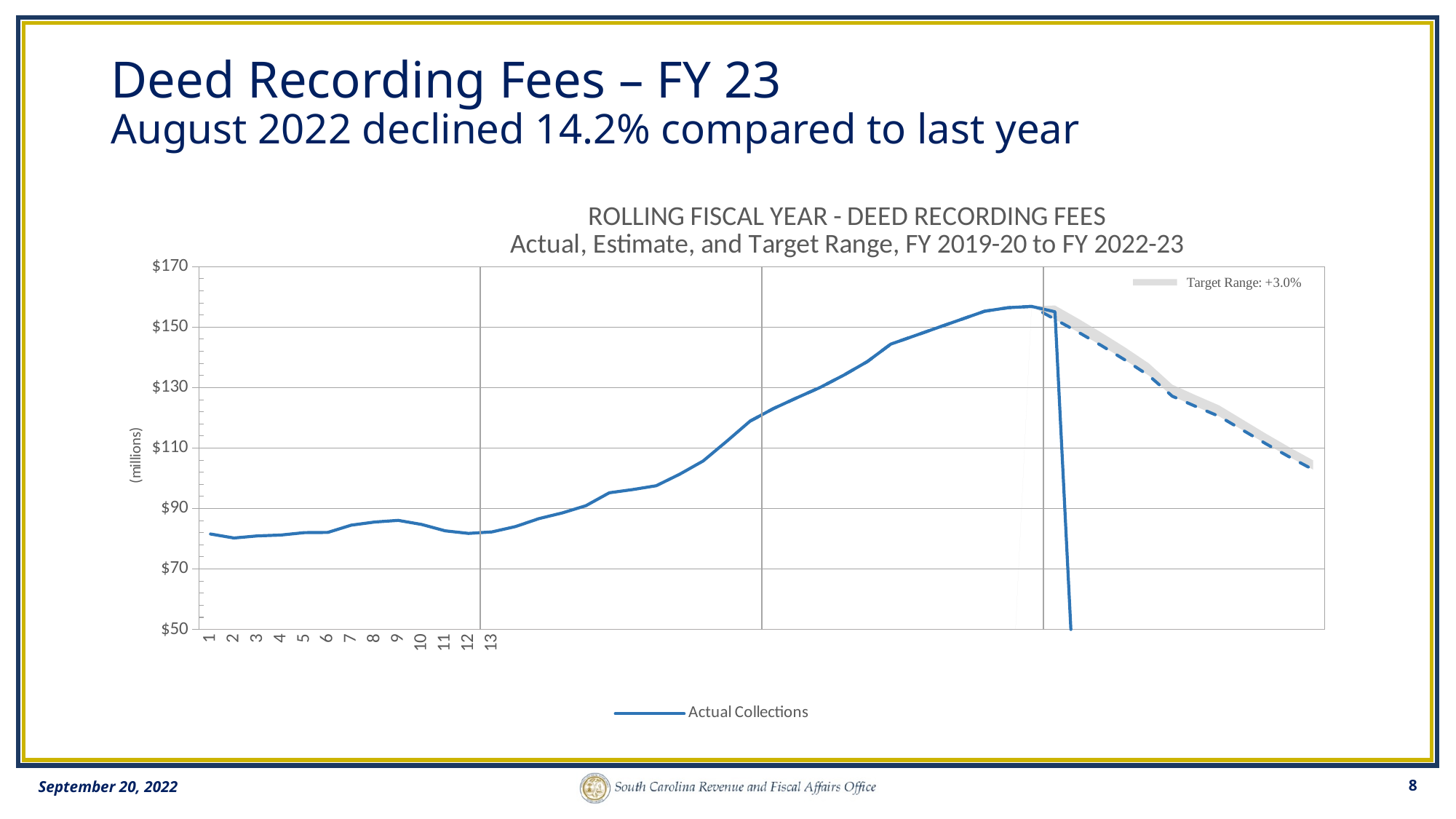
Is the peak value of the Actual Collections line greater or less than $150? greater What is the highest value shown on the y-axis? $170 What series name is shown in the legend below the chart? Actual Collections Is the Actual Collections value at x-axis point 9 greater or less than $110? less What kind of chart is shown on the slide? line chart Is the Actual Collections value at x-axis point 13 greater or less than $90? less Does the Actual Collections line generally rise or fall between x-axis point 13 and its peak? rise What is the title of the chart? ROLLING FISCAL YEAR - DEED RECORDING FEES Actual, Estimate, and Target Range, FY 2019-20 to FY 2022-23 How many numbered x-axis labels are shown on the chart? 13 Does the dashed estimate line rise or fall after the peak toward the right edge of the chart? fall